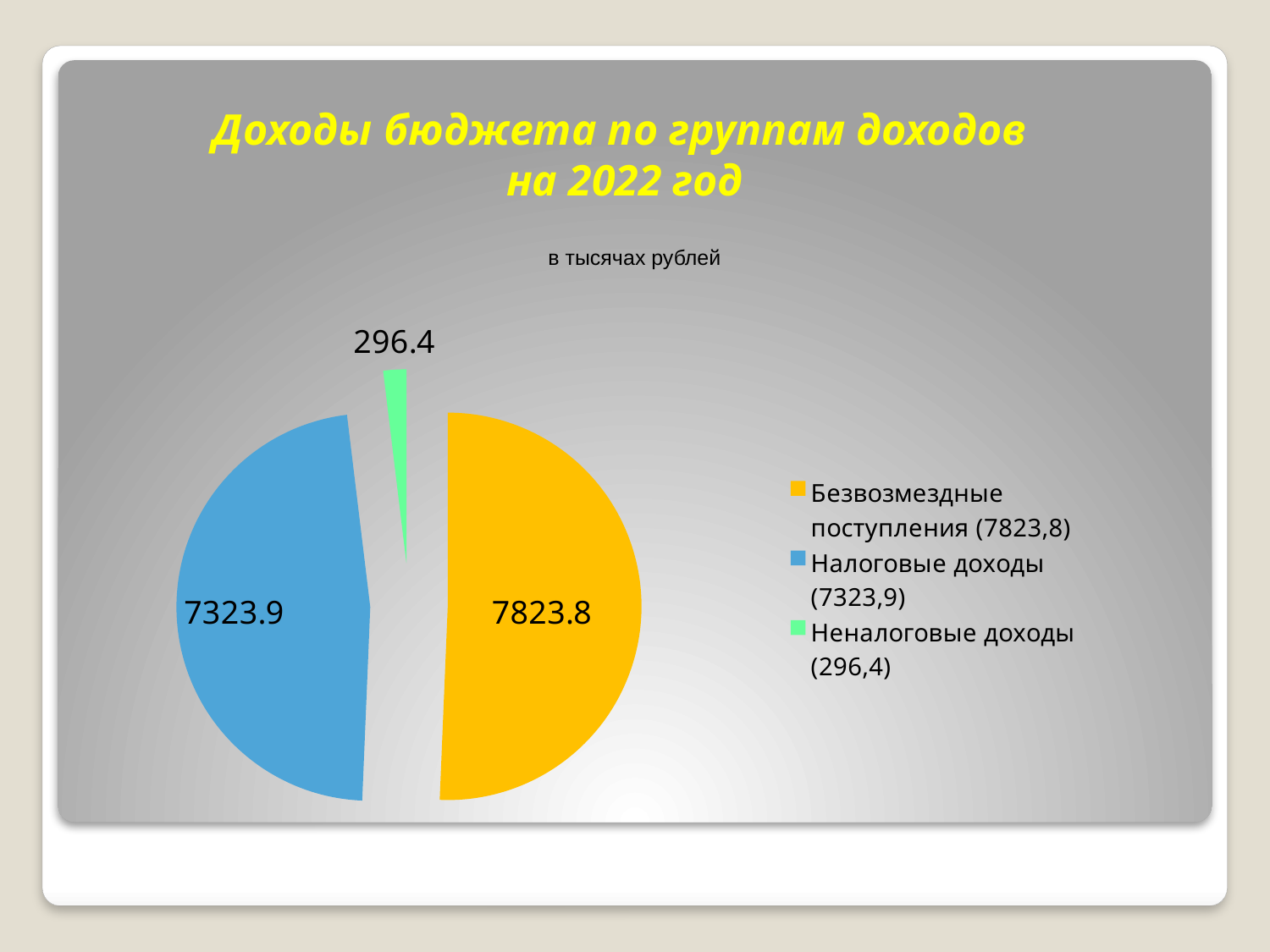
Which is larger, Налоговые доходы or Неналоговые доходы? Налоговые доходы What is the value for Налоговые доходы? 7323.9 What kind of chart is shown on the slide? Pie chart What is the difference between the values for Налоговые доходы and Неналоговые доходы? 7027.5 What is the title of the slide? Доходы бюджета по группам доходов на 2022 год In what units are the values given, according to the slide? в тысячах рублей What is the value for Безвозмездные поступления? 7823.8 Which category has the largest slice of the pie? Безвозмездные поступления How many slices does the pie chart have? 3 Which category has the smallest slice of the pie? Неналоговые доходы What is the difference between the values for Безвозмездные поступления and Налоговые доходы? 499.9 What is the value for Неналоговые доходы? 296.4